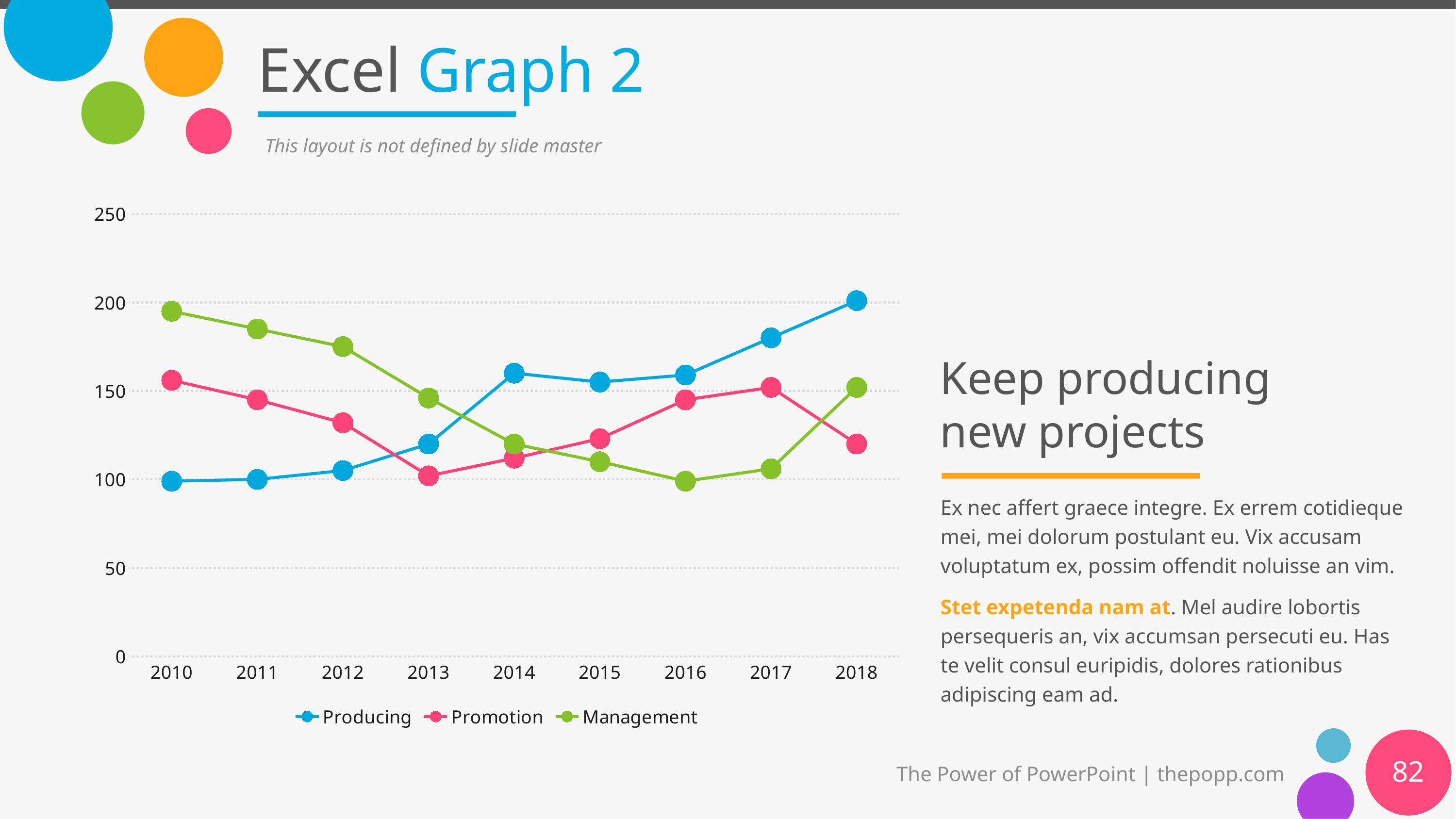
Is the value for Management in 2010 greater or less than 150? greater In 2010, which series has the larger value, Management or Producing? Management Which series are listed in the legend? Producing, Promotion, Management Is the value for Producing in 2018 greater or less than 150? greater How many years are shown on the x axis? 9 Is the value for Promotion in 2013 greater or less than 150? less In which year does the Management series have its highest value? 2010 Does the Management series rise or fall from 2010 to 2016? Fall What kind of chart is shown on the slide? Line chart How many series does the legend list? 3 In which year does the Producing series reach its highest value? 2018